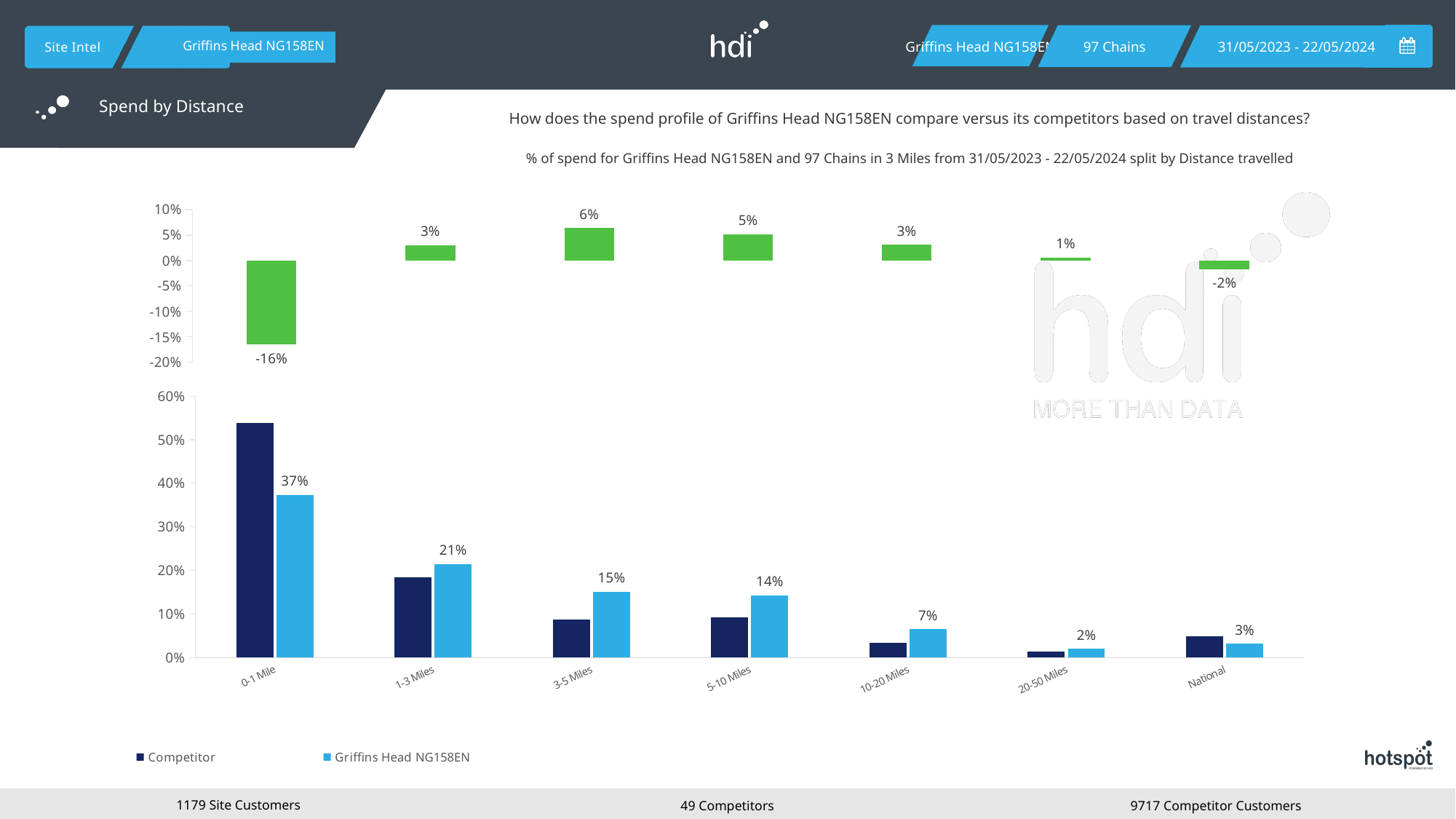
How many series does the legend of the bottom bar chart list? 2 In the bottom bar chart, in the 0-1 Mile category, which series has the larger value: Competitor or Griffins Head NG158EN? Competitor In the bottom bar chart, which category has the highest value for Griffins Head NG158EN? 0-1 Mile In the top green chart, what is the value shown for the 0-1 Mile category? -16% In the bottom bar chart, is the Competitor value for 3-5 Miles greater or less than 10%? less In the bottom bar chart, what is the value for Griffins Head NG158EN in the 5-10 Miles category? 14% In the bottom bar chart, what is the value for Griffins Head NG158EN in the 0-1 Mile category? 37% How many distance categories are shown on the x axis of the bottom bar chart? 7 In the top green chart, what is the value shown for the 3-5 Miles category? 6% In the bottom bar chart, is the Competitor value for 0-1 Mile greater or less than 50%? greater In the bottom bar chart, which category has the lowest value for Griffins Head NG158EN? 20-50 Miles In the bottom bar chart, what is the difference between the Griffins Head NG158EN values for 0-1 Mile and 1-3 Miles? 16%